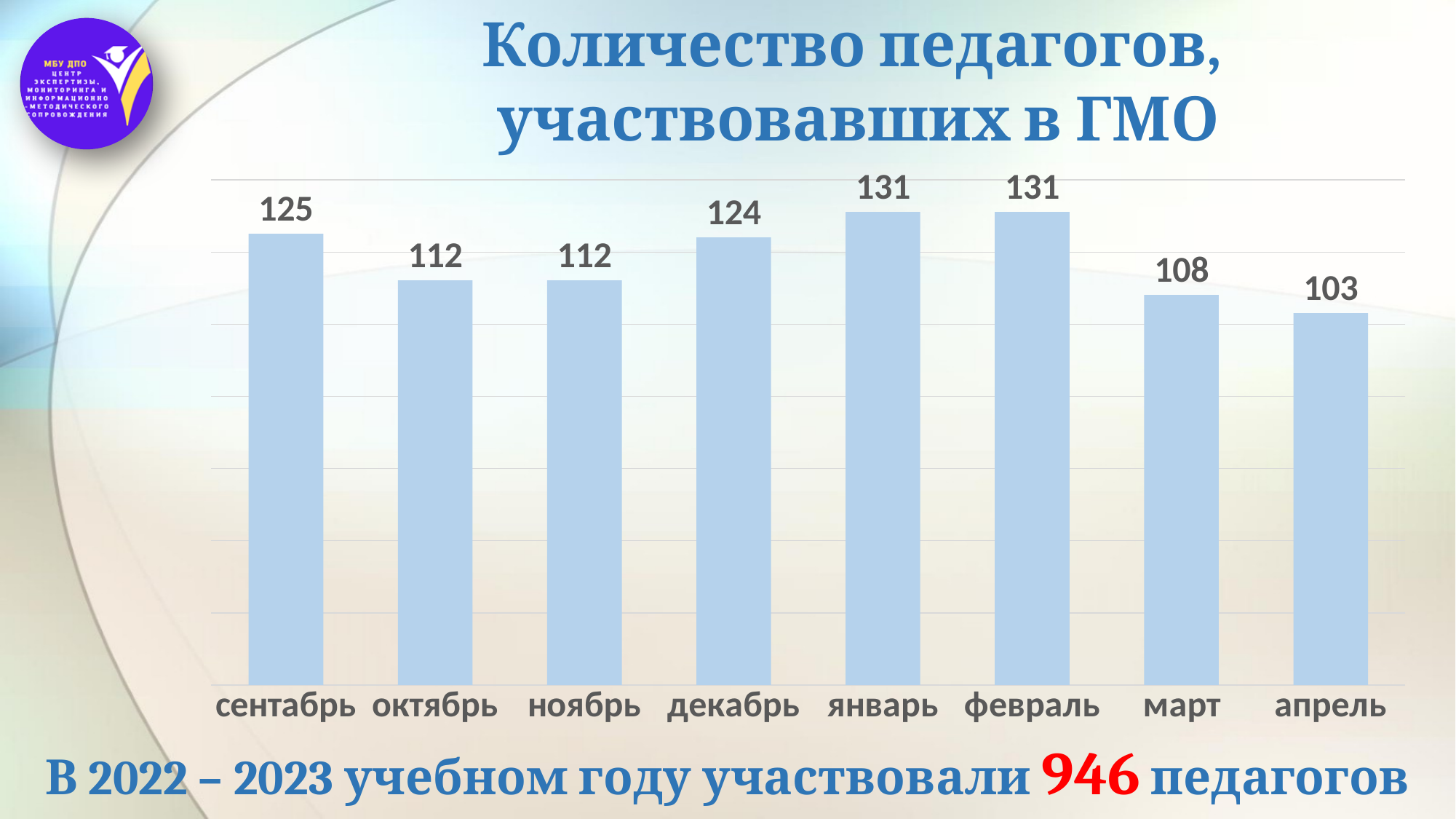
What is the highest value shown in the chart? 131 What is the difference between the values for сентябрь and апрель? 22 What is the value for декабрь? 124 How many months are shown in the chart? 8 Which month has the lowest value? апрель Which is larger, the value for декабрь or the value for октябрь? декабрь What is the value for март? 108 What is the difference between the values for февраль and март? 23 What is the value for сентябрь? 125 What is the value for январь? 131 What is the title of the chart? Количество педагогов, участвовавших в ГМО What kind of chart is shown on the slide? bar chart